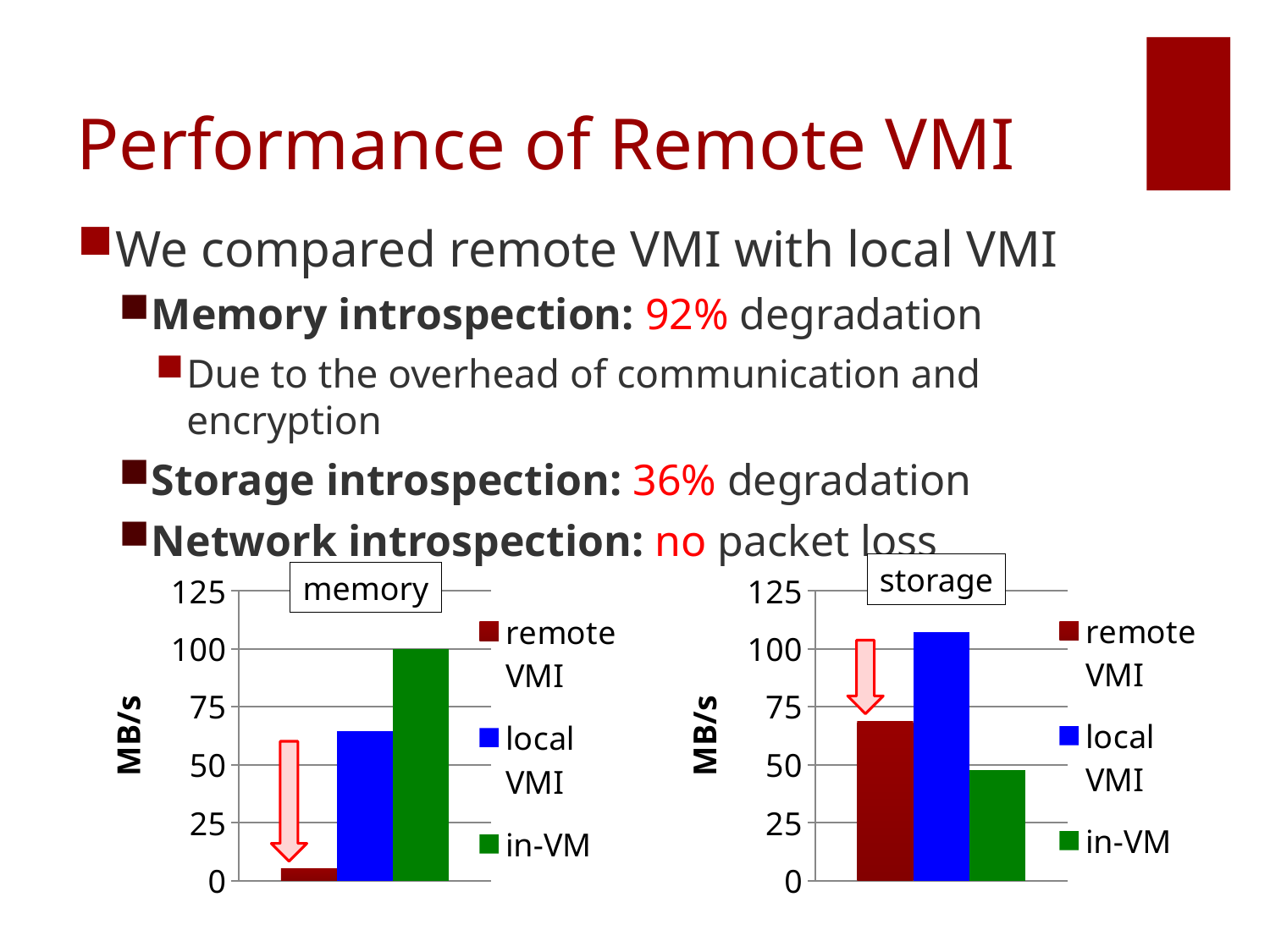
What kind of chart is the memory chart? bar chart In the memory chart, is the value for local VMI greater or less than 50? greater In the storage chart, is the value for local VMI greater or less than 100? greater In the memory chart, which series has the highest value? in-VM In the storage chart, which series has the highest value? local VMI What is the label on the vertical axis of the memory chart? MB/s In the storage chart, which is larger, remote VMI or in-VM? remote VMI In the storage chart, is the value for remote VMI greater or less than 75? less In the storage chart, which series has the lowest value? in-VM How many series does the legend of the storage chart list? 3 In the memory chart, which series has the lowest value? remote VMI